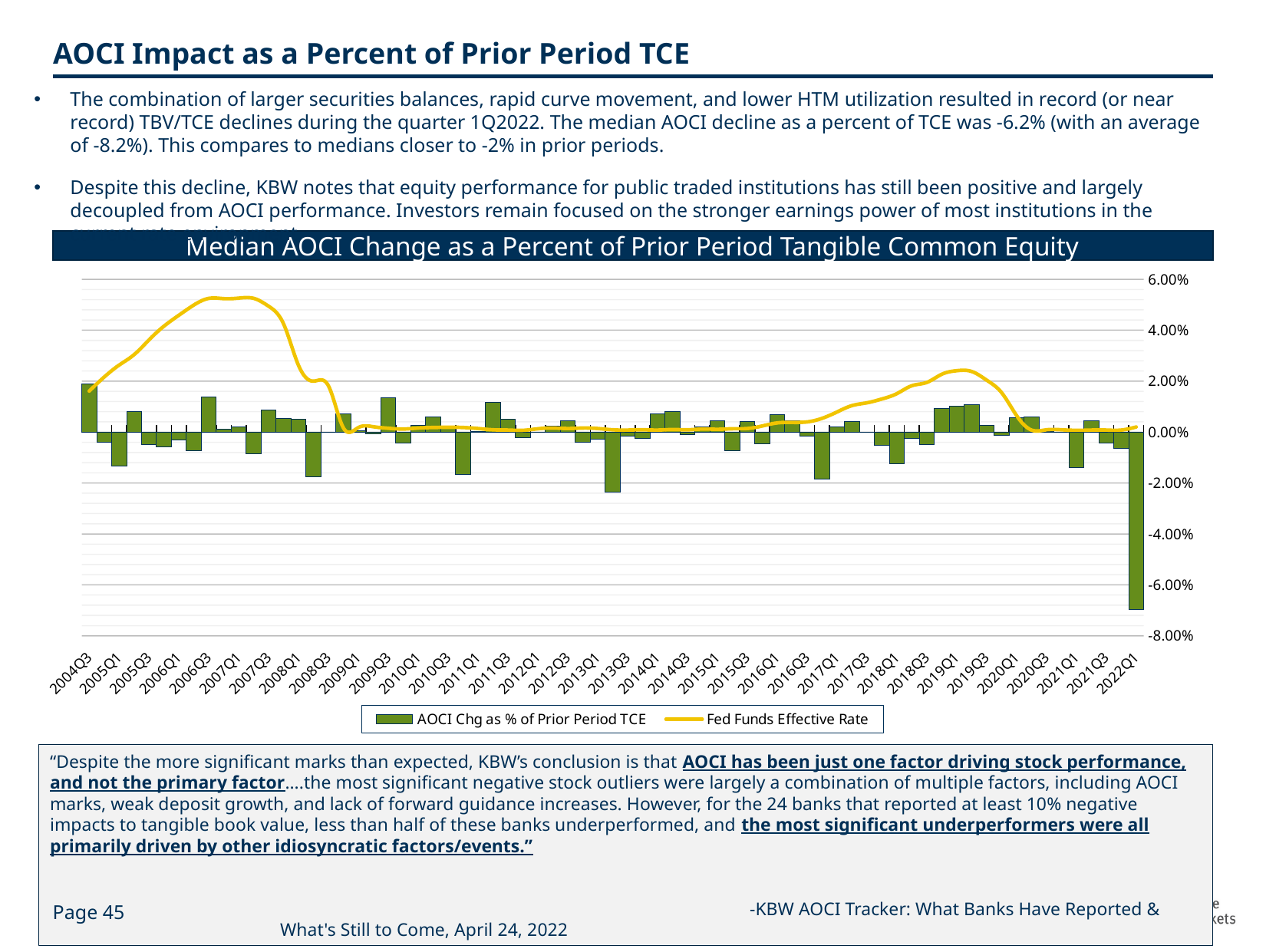
Does the Fed Funds Effective Rate rise or fall from 2004Q3 to 2007Q1? rise What is the title of the chart? Median AOCI Change as a Percent of Prior Period Tangible Common Equity How many series does the chart legend list? 2 Is the Fed Funds Effective Rate for 2007Q1 greater or less than 4.00%? greater Is the Fed Funds Effective Rate for 2012Q1 greater or less than 2.00%? less Does the Fed Funds Effective Rate rise or fall from 2007Q3 to 2009Q1? fall Is the AOCI Chg as % of Prior Period TCE value for 2004Q3 greater or less than 1.00%? greater Which quarter has the lowest AOCI Chg as % of Prior Period TCE bar? 2022Q1 What kind of chart is shown on the slide? Combination bar and line chart Which is larger, the AOCI Chg as % of Prior Period TCE for 2004Q3 or for 2022Q1? 2004Q3 Which series is plotted as a line in the chart? Fed Funds Effective Rate